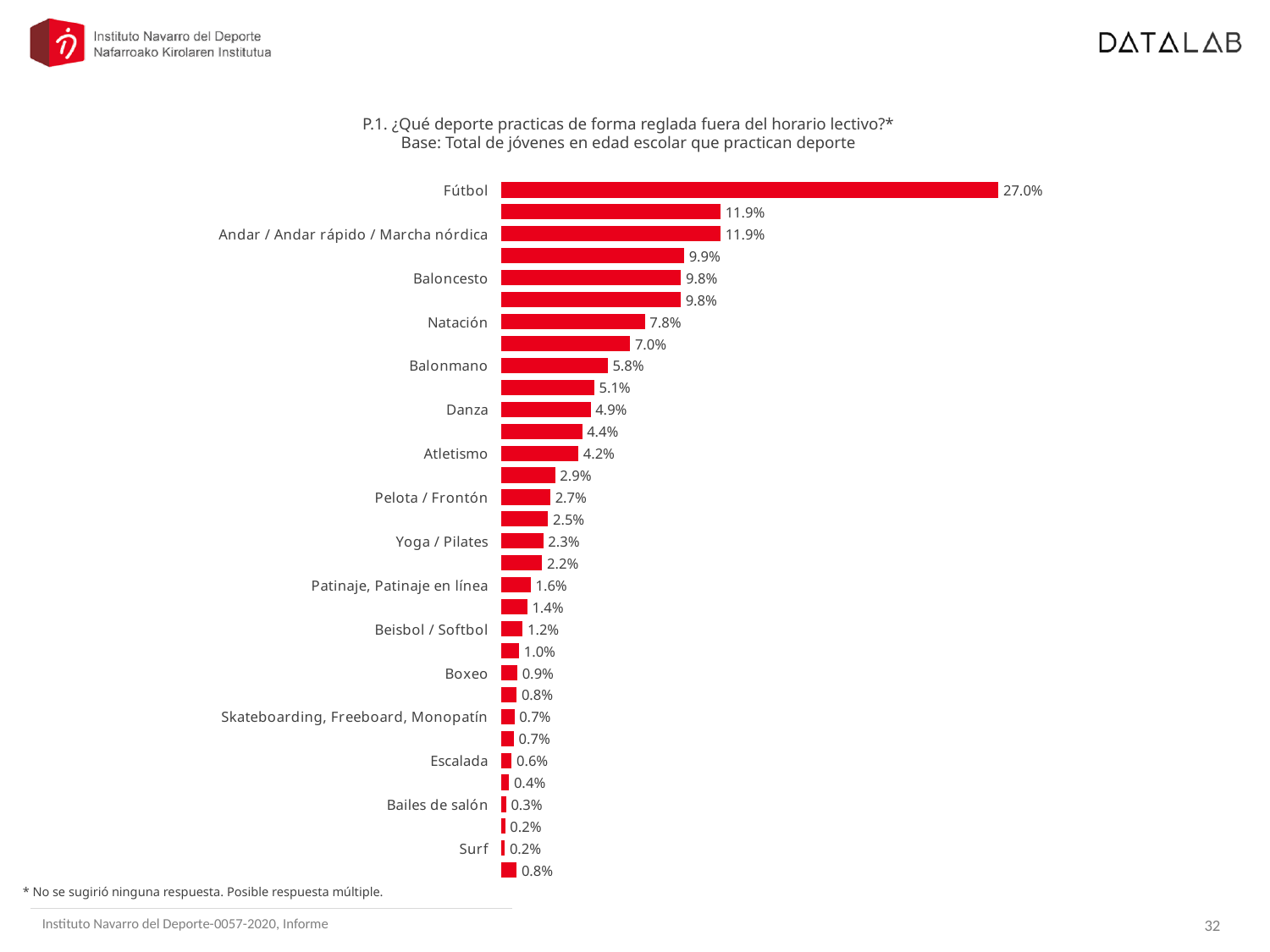
What is the difference between the values for Fútbol and Andar / Andar rápido / Marcha nórdica? 15.1% What is the value shown for Surf? 0.2% What is the base population stated under the chart title? Total de jóvenes en edad escolar que practican deporte What is the value shown for Yoga / Pilates? 2.3% What is the value shown for Andar / Andar rápido / Marcha nórdica? 11.9% What is the value shown for Natación? 7.8% Which sport has the highest value in the chart? Fútbol What type of chart is shown on the slide? Bar chart What percentage of young people practice Fútbol according to the chart? 27.0% What is the value shown for Baloncesto? 9.8% What is the difference between the values for Baloncesto and Natación? 2.0% Which has a larger value, Balonmano or Danza? Balonmano